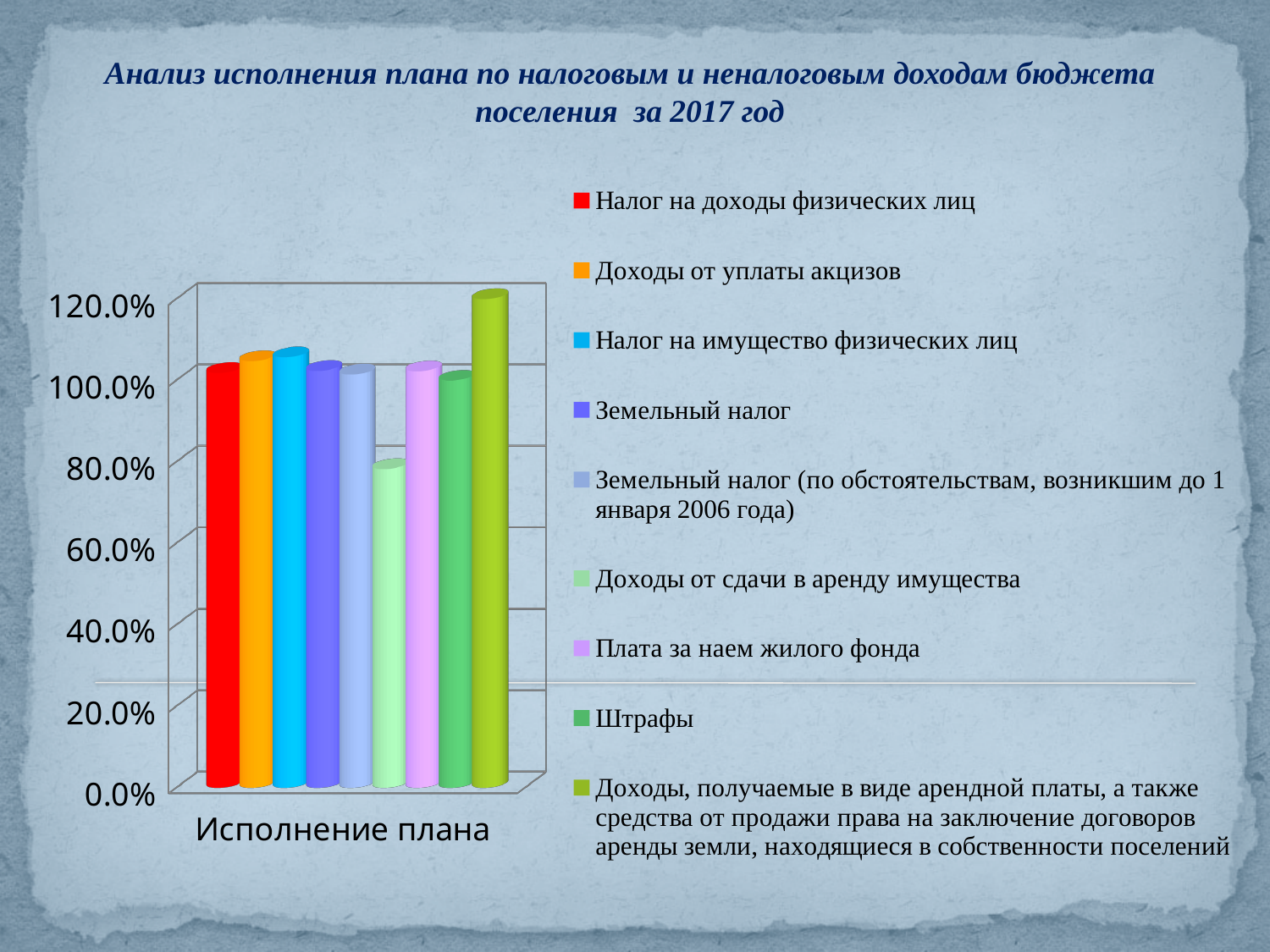
What kind of chart is shown on the slide? bar chart Which series has the lowest value? Доходы от сдачи в аренду имущества What is the label of the category on the x axis? Исполнение плана How many series does the legend list? 9 Which series is shown in red in the legend? Налог на доходы физических лиц How many categories are shown on the x axis? 1 Which is larger: the value for Штрафы or the value for Доходы, получаемые в виде арендной платы, а также средства от продажи права на заключение договоров аренды земли, находящиеся в собственности поселений? Доходы, получаемые в виде арендной платы, а также средства от продажи права на заключение договоров аренды земли, находящиеся в собственности поселений Is the value for Налог на доходы физических лиц greater or less than 80.0%? greater Which series has the highest value? Доходы, получаемые в виде арендной платы, а также средства от продажи права на заключение договоров аренды земли, находящиеся в собственности поселений Is the value for Штрафы greater or less than 60.0%? greater Which is larger: the value for Доходы от сдачи в аренду имущества or the value for Налог на доходы физических лиц? Налог на доходы физических лиц Is the value for Доходы от сдачи в аренду имущества greater or less than 100.0%? less